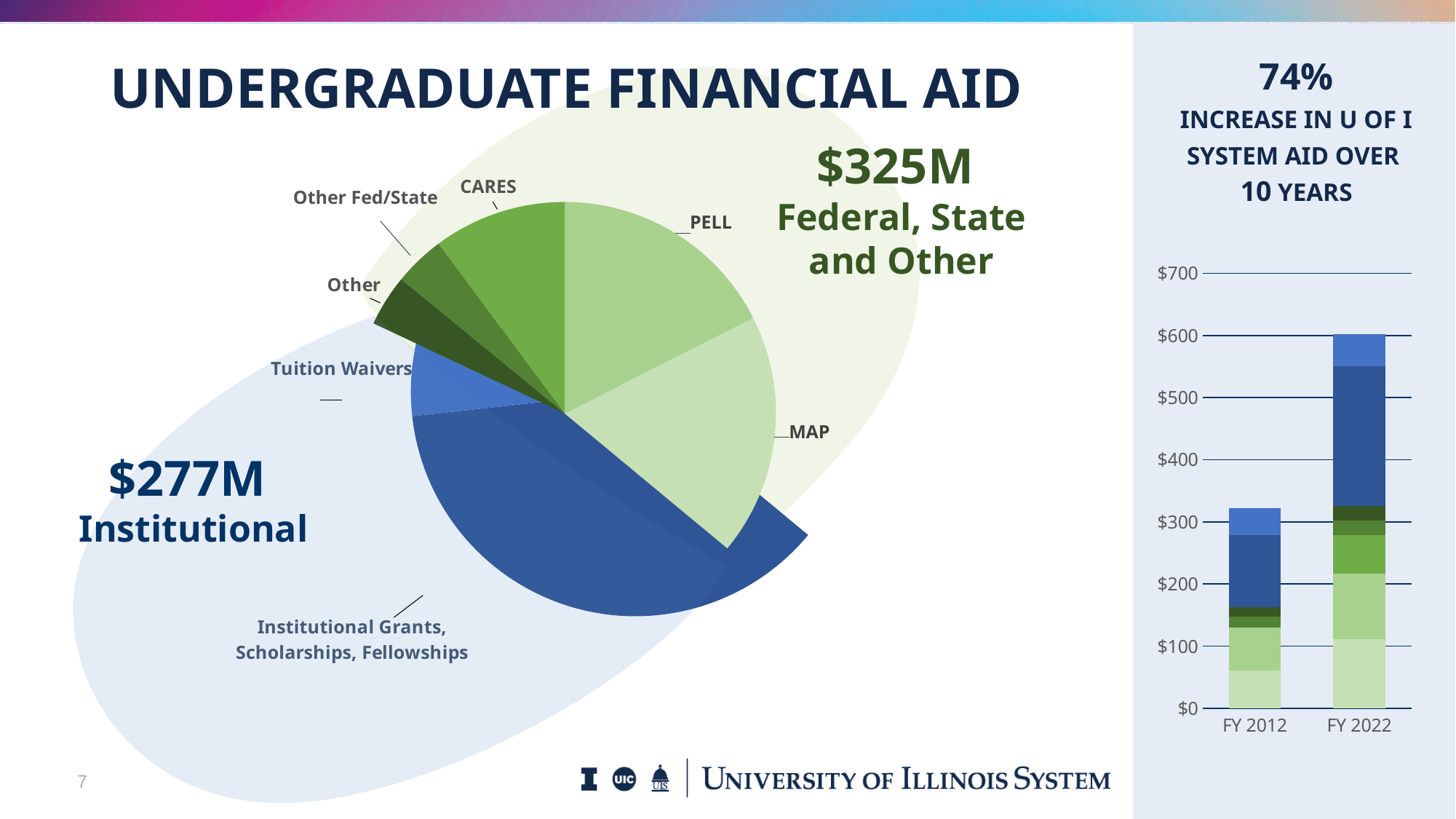
What kind of chart is the large chart in the centre of the slide? pie chart In the pie chart, what is the total amount shown for Institutional aid? $277M In the pie chart, which slice is larger: Institutional Grants, Scholarships, Fellowships or PELL? Institutional Grants, Scholarships, Fellowships In the pie chart, which is larger: the Federal, State and Other total or the Institutional total? Federal, State and Other In the bar chart on the right, how many fiscal years are shown on the x axis? 2 In the bar chart on the right, is the total for FY 2012 greater or less than $400? less What kind of chart is shown on the right side of the slide under the '74%' heading? bar chart In the pie chart, what is the total amount shown for Federal, State and Other aid? $325M In the bar chart on the right, does total aid rise or fall from FY 2012 to FY 2022? rise In the pie chart, which slice is the largest? Institutional Grants, Scholarships, Fellowships In the pie chart, what is the difference between the Federal, State and Other total and the Institutional total? $48M How many labelled slices does the pie chart have? 7